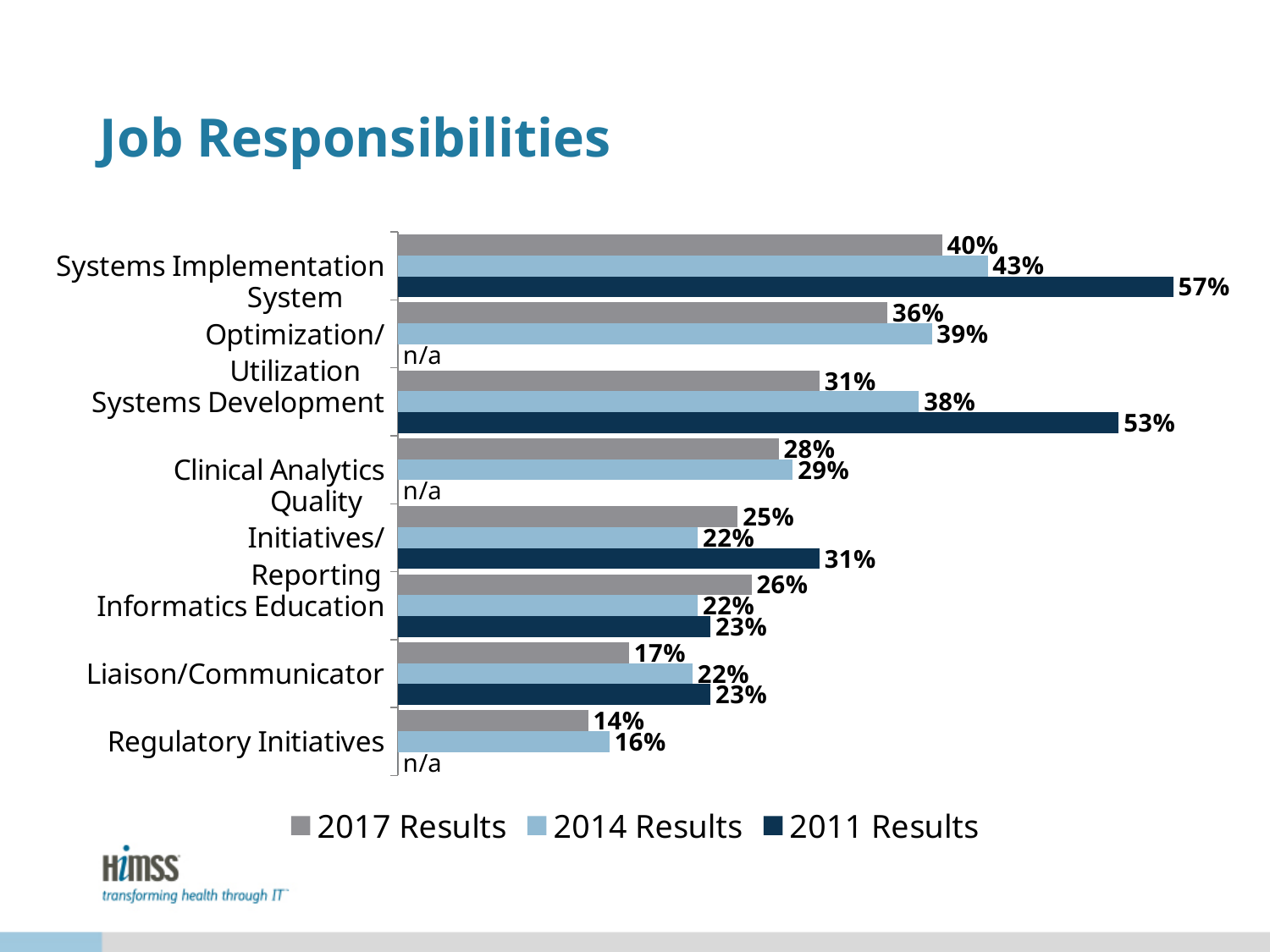
Which category has the highest 2017 Results value? Systems Implementation What value is shown for the 2011 Results for Clinical Analytics? n/a What is the difference between the 2011 Results and 2017 Results values for Systems Implementation? 17% What is the title of the chart? Job Responsibilities How many series does the legend list? 3 What is the 2017 Results value for Systems Development? 31% What is the 2014 Results value for Liaison/Communicator? 22% How many job responsibility categories are shown on the chart? 8 Which is larger for Informatics Education: the 2017 Results value or the 2011 Results value? 2017 Results What kind of chart is shown on the slide? Bar chart Which category has the lowest 2014 Results value? Regulatory Initiatives What is the 2011 Results value for Systems Implementation? 57%